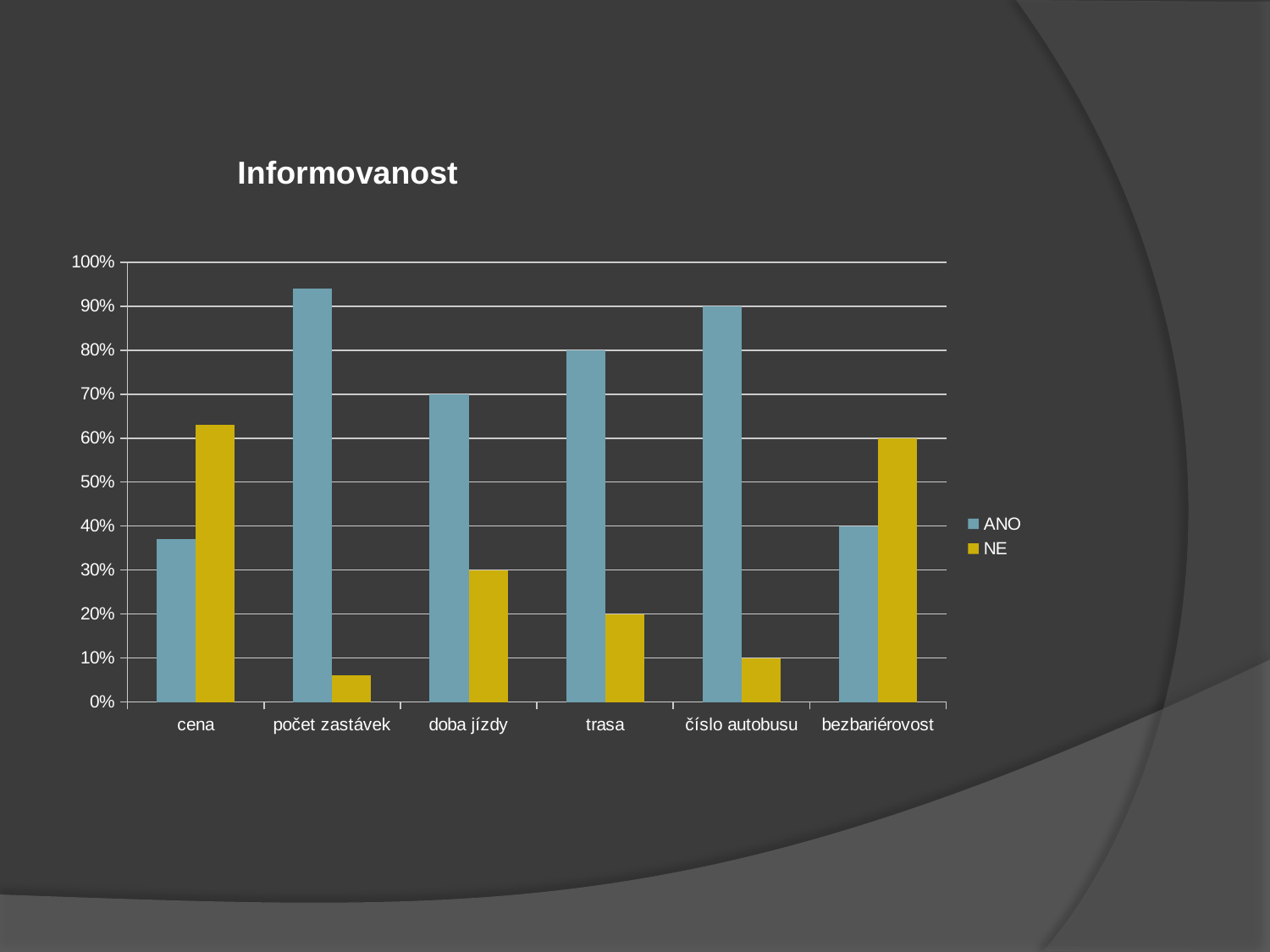
Which category has the highest ANO value? počet zastávek What is the ANO value for trasa? 80% Which category has the highest NE value? cena What is the title of the chart? Informovanost How many series does the legend list? 2 What kind of chart is shown on the slide? bar chart For číslo autobusu, which is larger, the ANO value or the NE value? ANO How many categories are shown on the x axis? 6 What is the NE value for bezbariérovost? 60% Which category has the lowest NE value? počet zastávek Which category has the lowest ANO value? cena Is the ANO value for cena greater or less than 40%? less